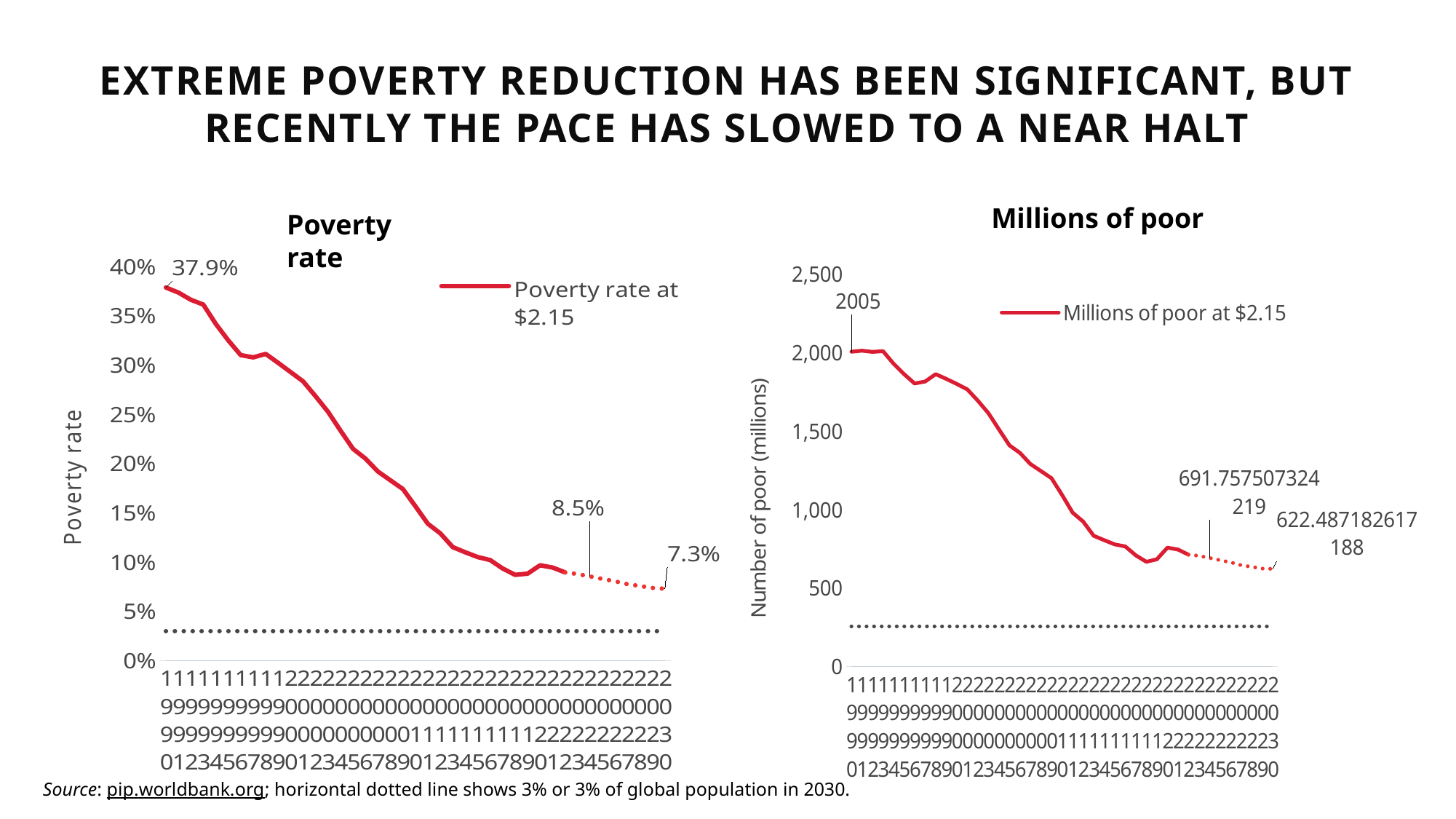
What is the legend entry on the Poverty rate chart? Poverty rate at $2.15 On the Millions of poor chart, what is the value labelled at the start of the line? 2005 What kind of chart is the Poverty rate chart on the left? line chart On the Millions of poor chart, what is the value labelled at the end of the dotted projection? 622.487182617188 On the Poverty rate chart, do the values rise or fall from left to right along the x axis? fall On the Poverty rate chart, what is the value labelled at the end of the dotted projection (2030)? 7.3% On the Poverty rate chart, what is the difference between the first labelled value (37.9%) and the last labelled value (7.3%)? 30.6 percentage points On the Millions of poor chart, is the value for 2000 greater or less than 1,500? greater How many series does the legend of the Millions of poor chart list? 1 On the Millions of poor chart, which labelled value is larger: 691.757507324219 or 622.487182617188? 691.757507324219 On the Poverty rate chart, what is the value labelled at the start of the line (1990)? 37.9%